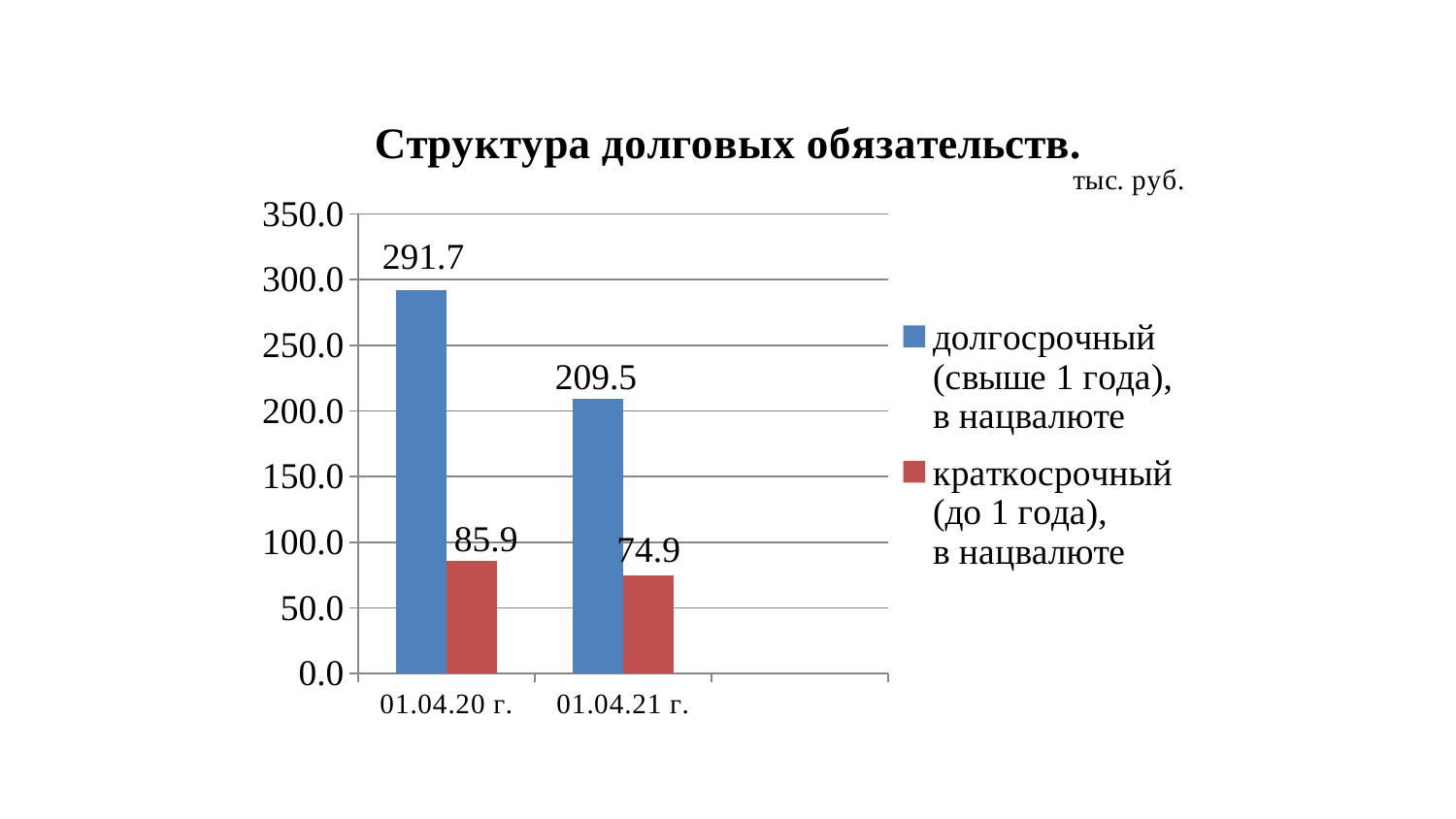
What is the value of краткосрочный (до 1 года), в нацвалюте for 01.04.20 г.? 85.9 Which is larger for 01.04.21 г.: долгосрочный or краткосрочный? долгосрочный Which date has the highest value for долгосрочный (свыше 1 года), в нацвалюте? 01.04.20 г. What is the difference between the краткосрочный values for 01.04.20 г. and 01.04.21 г.? 11.0 What is the value of долгосрочный (свыше 1 года), в нацвалюте for 01.04.20 г.? 291.7 How many series does the legend list? 2 What is the value of долгосрочный (свыше 1 года), в нацвалюте for 01.04.21 г.? 209.5 Which date has the lowest value for краткосрочный (до 1 года), в нацвалюте? 01.04.21 г. What is the title of the chart? Структура долговых обязательств. What is the value of краткосрочный (до 1 года), в нацвалюте for 01.04.21 г.? 74.9 What is the difference between the долгосрочный values for 01.04.20 г. and 01.04.21 г.? 82.2 What kind of chart is shown on the slide? bar chart